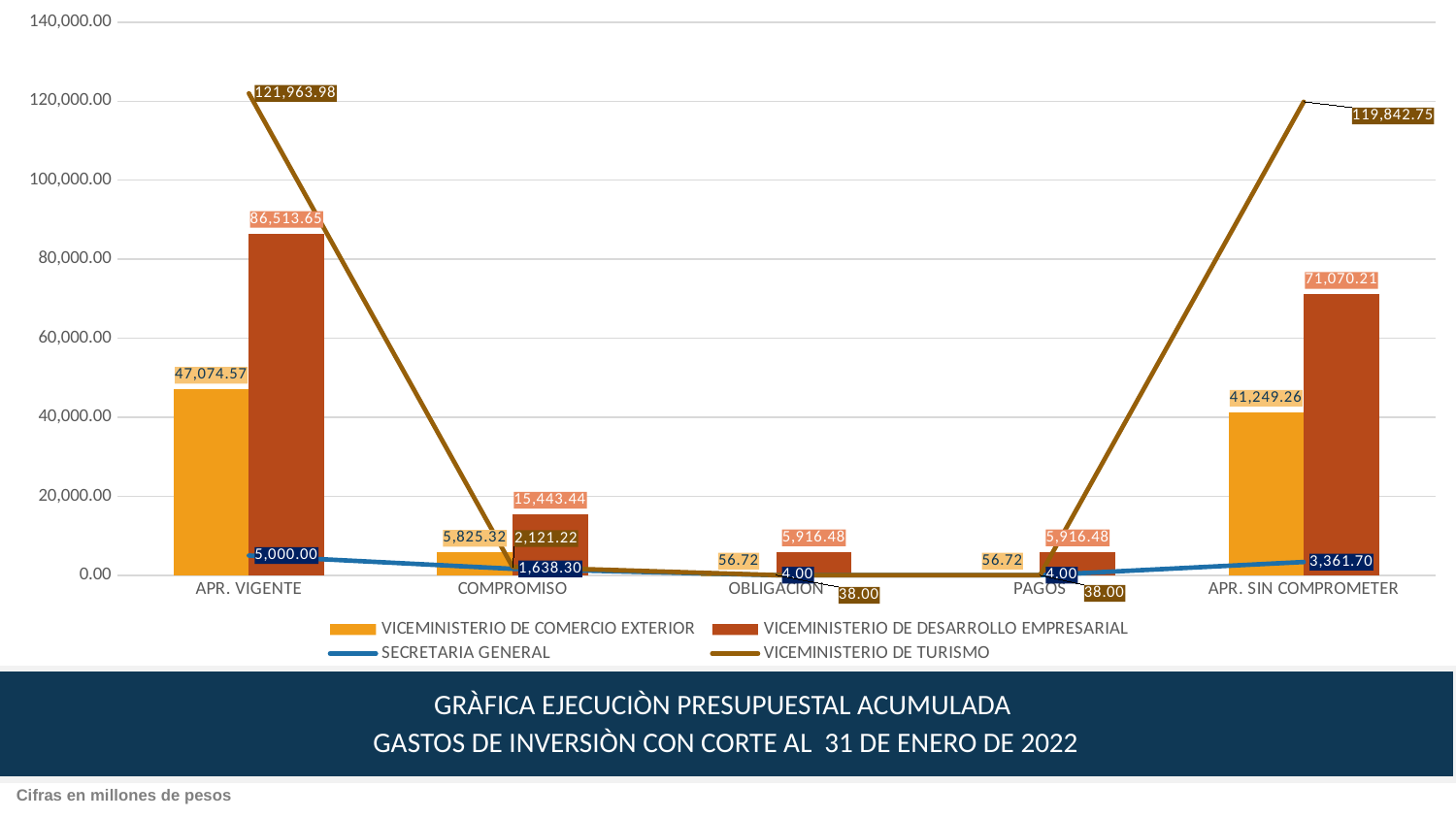
Which is larger at COMPROMISO: VICEMINISTERIO DE COMERCIO EXTERIOR or VICEMINISTERIO DE DESARROLLO EMPRESARIAL? VICEMINISTERIO DE DESARROLLO EMPRESARIAL What is the value for VICEMINISTERIO DE COMERCIO EXTERIOR at PAGOS? 56.72 What is the value for SECRETARIA GENERAL at COMPROMISO? 1,638.30 What kind of chart is this? Combined bar and line chart What is the value for VICEMINISTERIO DE TURISMO at APR. SIN COMPROMETER? 119,842.75 How many categories are shown on the x axis? 5 Which category has the highest value for VICEMINISTERIO DE TURISMO? APR. VIGENTE Which category has the lowest value for VICEMINISTERIO DE COMERCIO EXTERIOR, APR. VIGENTE or COMPROMISO? COMPROMISO What is the value for VICEMINISTERIO DE DESARROLLO EMPRESARIAL at APR. VIGENTE? 86,513.65 Is the value for VICEMINISTERIO DE TURISMO at APR. VIGENTE greater or less than 100,000.00? greater What is the difference between the VICEMINISTERIO DE DESARROLLO EMPRESARIAL values at APR. VIGENTE and APR. SIN COMPROMETER? 15,443.44 How many series does the legend list? 4